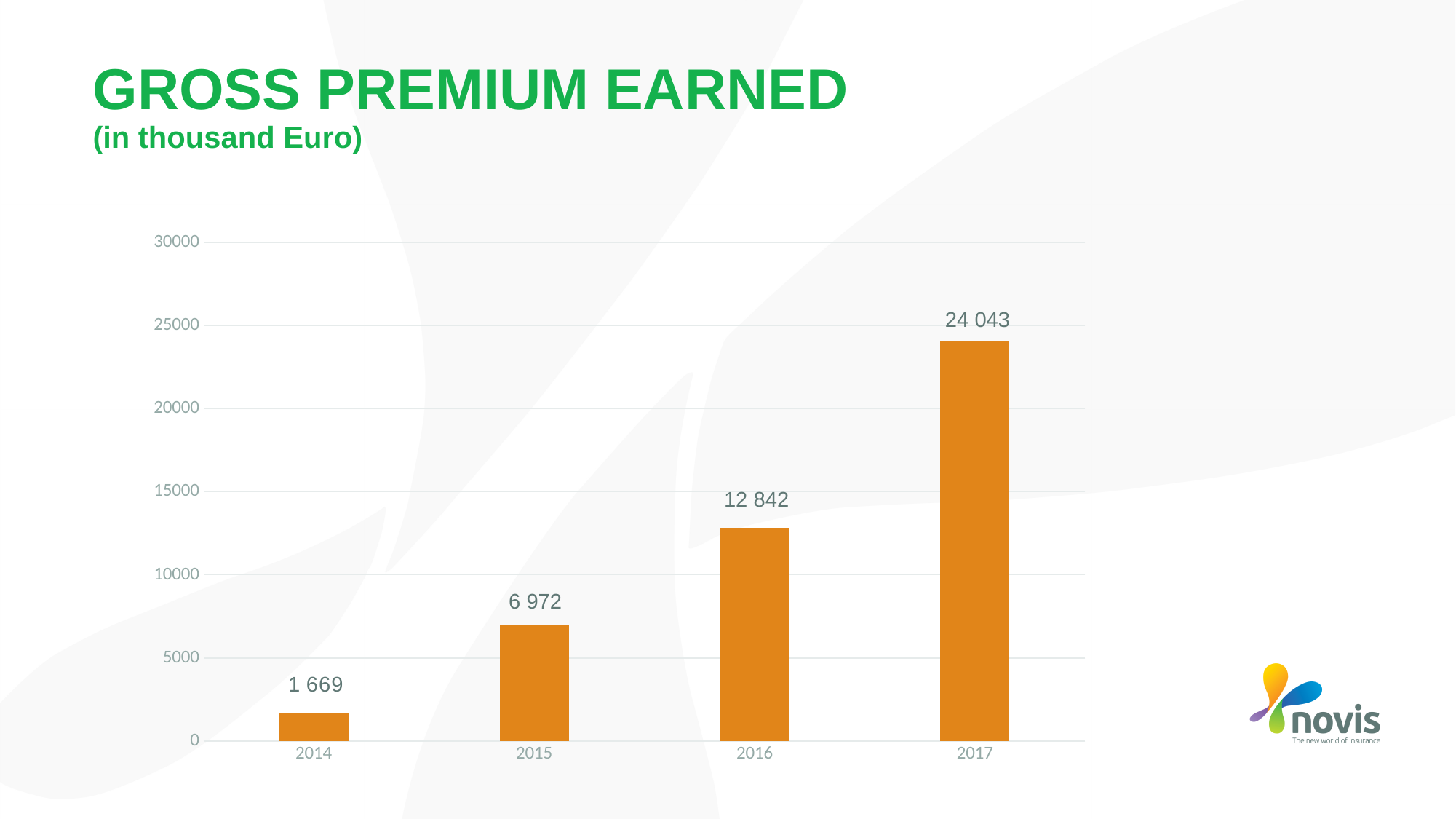
What is the difference between the gross premium earned in 2017 and in 2016? 11 201 What is the gross premium earned for 2014? 1 669 What is the difference between the gross premium earned in 2015 and in 2014? 5 303 What kind of chart is shown on the slide? Bar chart Which year has the highest gross premium earned? 2017 Which year has a larger gross premium earned, 2015 or 2016? 2016 How many years are shown on the chart? 4 What is the gross premium earned for 2017? 24 043 Which year has the lowest gross premium earned? 2014 What is the gross premium earned for 2015? 6 972 Do the values rise or fall from 2014 to 2017? Rise What is the gross premium earned for 2016? 12 842